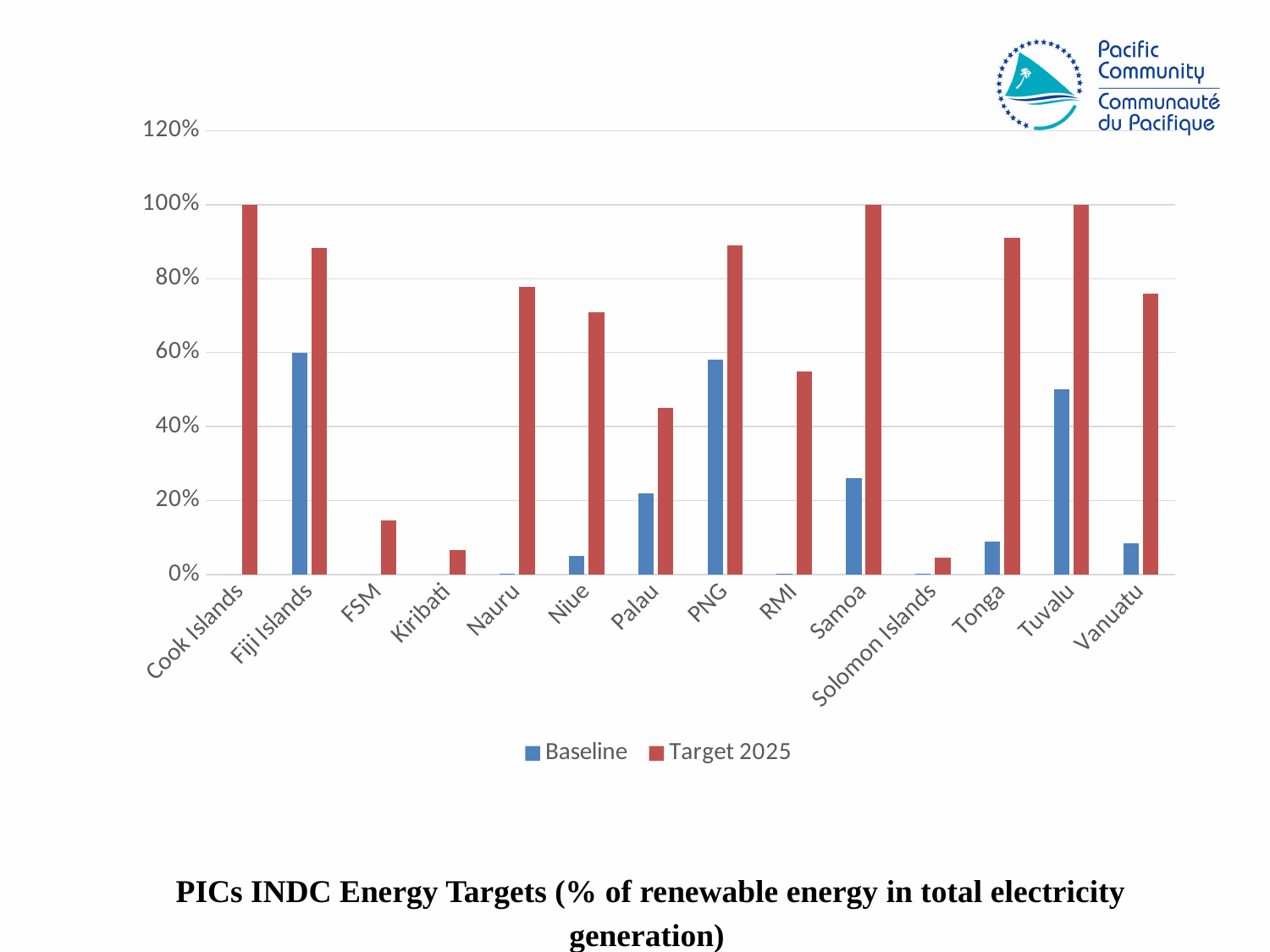
What is the Target 2025 value for Cook Islands? 100% How many countries are shown on the x axis? 14 Is the Baseline value for Samoa greater or less than 20%? greater Which series is shown in red? Target 2025 What is the Target 2025 value for Samoa? 100% Is the Target 2025 value for Palau greater or less than 60%? less Is the Target 2025 value for FSM greater or less than 20%? less What kind of chart is shown on the slide? bar chart Which has the higher Target 2025 value, Fiji Islands or Nauru? Fiji Islands How many series does the legend list? 2 Which has the higher Baseline value, Tuvalu or Samoa? Tuvalu